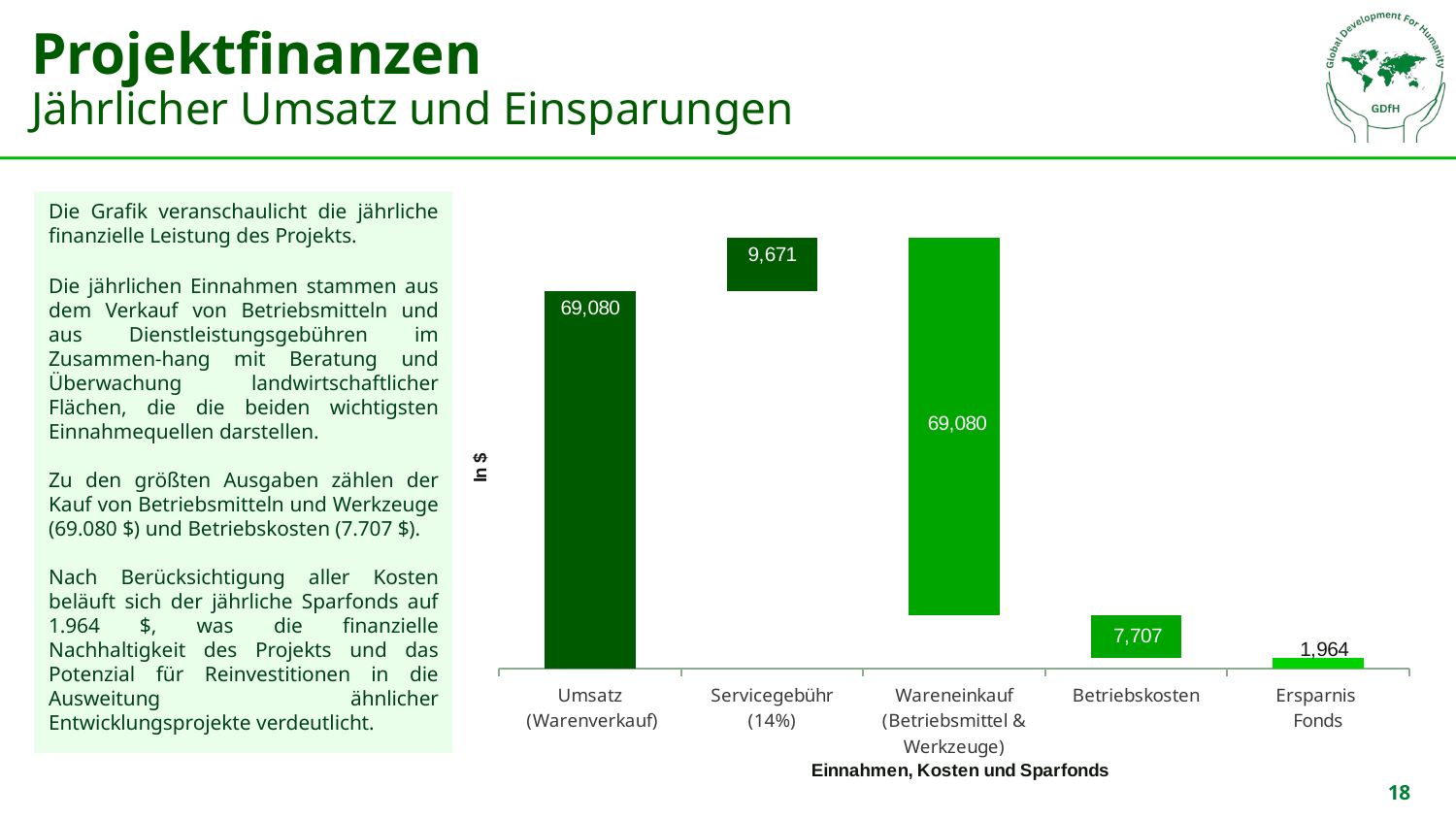
What is the value for Ersparnis Fonds? 1,964 What is the difference between Betriebskosten and Ersparnis Fonds? 5,743 What is the value for Servicegebühr (14%)? 9,671 Which category has the lowest value? Ersparnis Fonds How many categories are shown on the x axis? 5 What is the value for Wareneinkauf (Betriebsmittel & Werkzeuge)? 69,080 What is the value for Betriebskosten? 7,707 What kind of chart is shown? bar chart What is the title of the x axis? Einnahmen, Kosten und Sparfonds What is the value for Umsatz (Warenverkauf)? 69,080 What is the difference between Umsatz (Warenverkauf) and Servicegebühr (14%)? 59,409 Which is larger, Servicegebühr (14%) or Betriebskosten? Servicegebühr (14%)